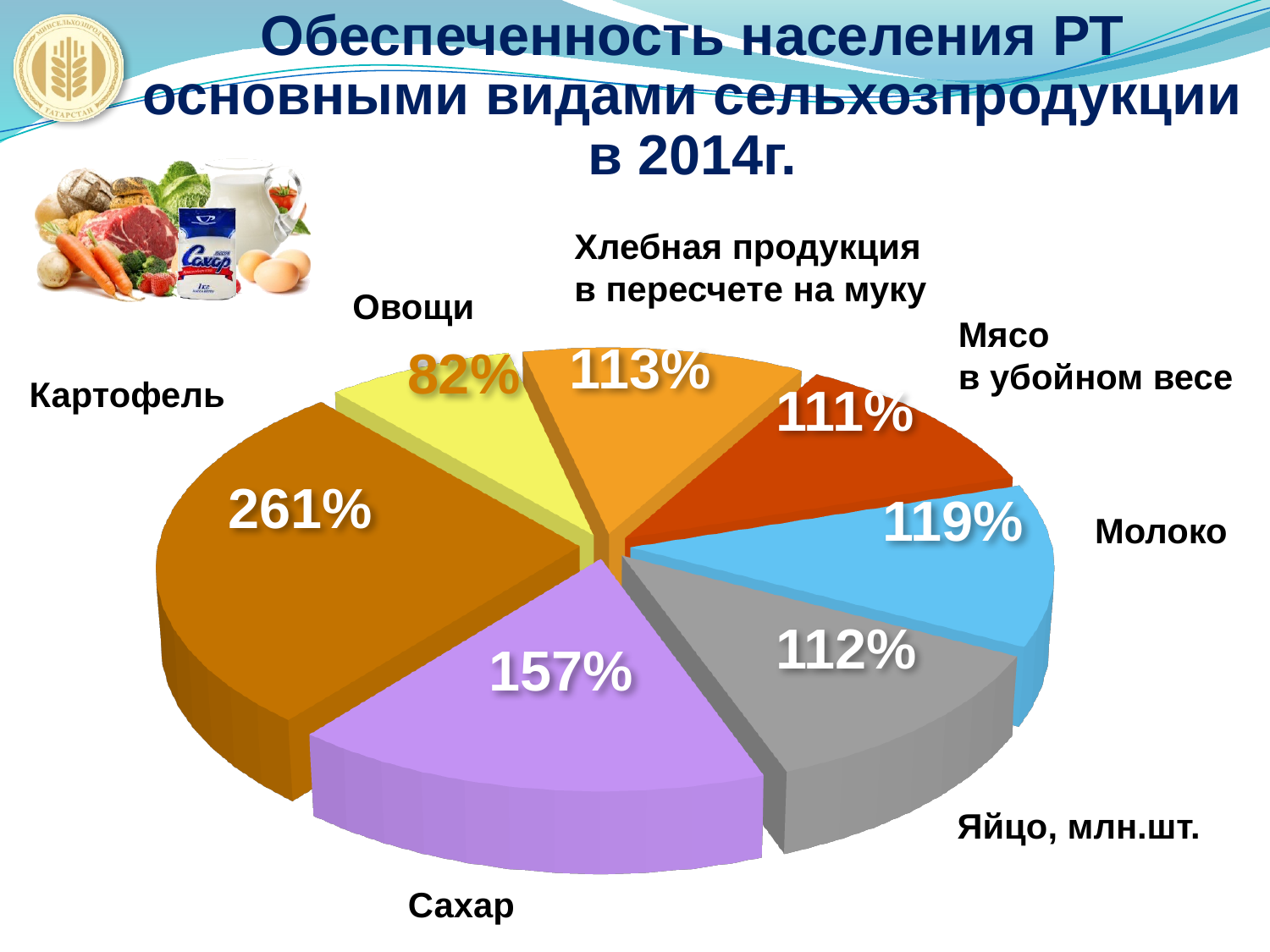
Which has a larger value, Молоко or Яйцо? Молоко What is the value shown for Молоко? 119% What year does the chart title refer to? 2014 What is the value shown for Мясо в убойном весе? 111% What is the value shown for Картофель? 261% Which category has the highest value? Картофель What is the value shown for Сахар? 157% How many categories are shown in the pie chart? 7 Which category has the lowest value? Овощи What is the difference between the values for Картофель and Сахар? 104% What kind of chart is shown on the slide? Pie chart What is the value shown for Овощи? 82%